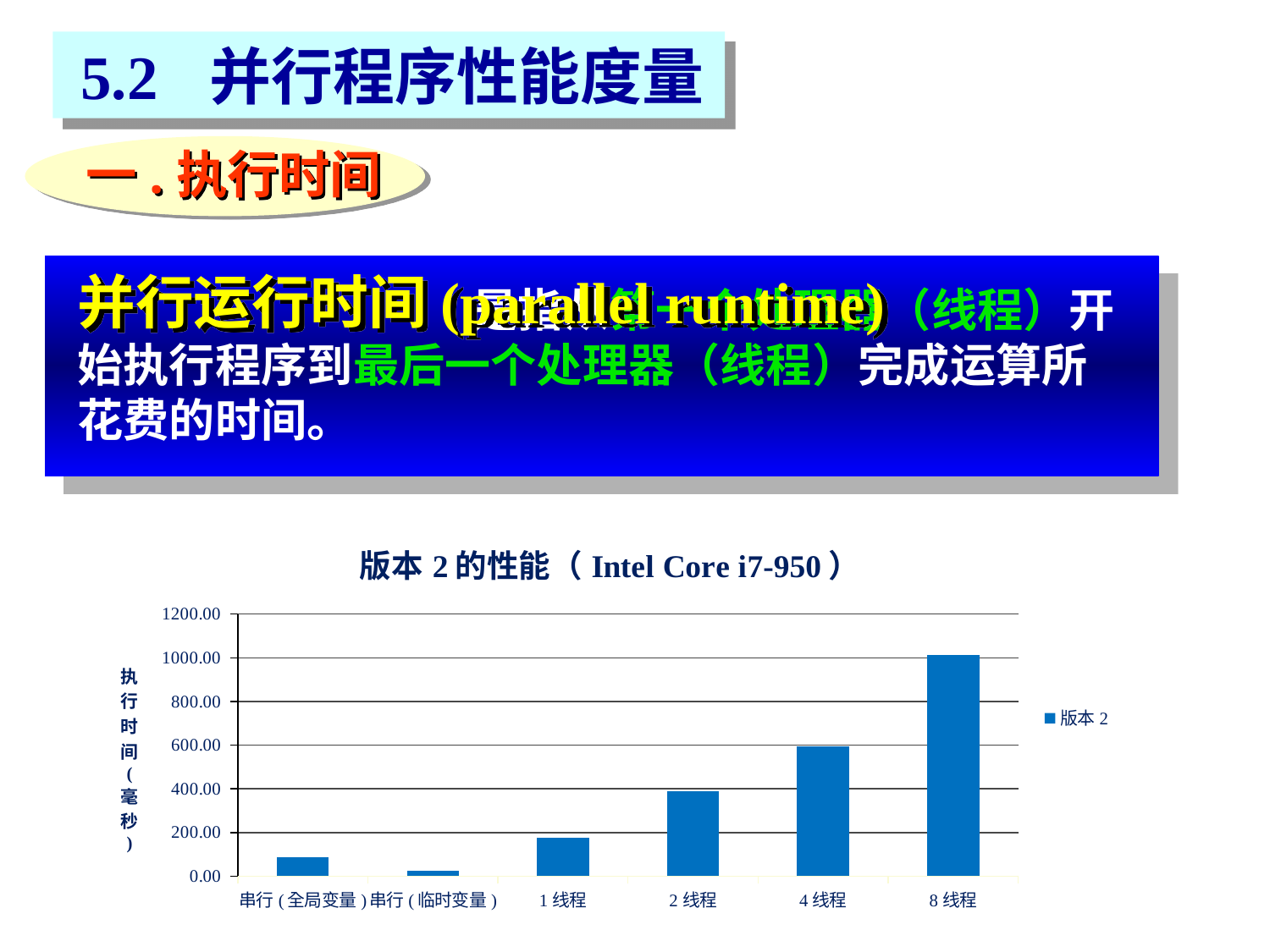
Which category has the lowest execution time in the chart? 串行 ( 临时变量 ) Which has a larger execution time, 串行 ( 全局变量 ) or 串行 ( 临时变量 )? 串行 ( 全局变量 ) How many series does the chart's legend list? 1 What is the title of the chart? 版本 2 的性能（ Intel Core i7-950 ） Which has a larger execution time, 2 线程 or 4 线程? 4 线程 What kind of chart is shown on the slide? bar chart Do the execution times rise or fall as the number of threads increases from 1 线程 to 8 线程? rise How many categories are plotted along the x axis of the chart? 6 Is the value for 4 线程 greater or less than 400.00? greater Is the value for 1 线程 greater or less than 200.00? less Which category has the highest execution time in the chart? 8 线程